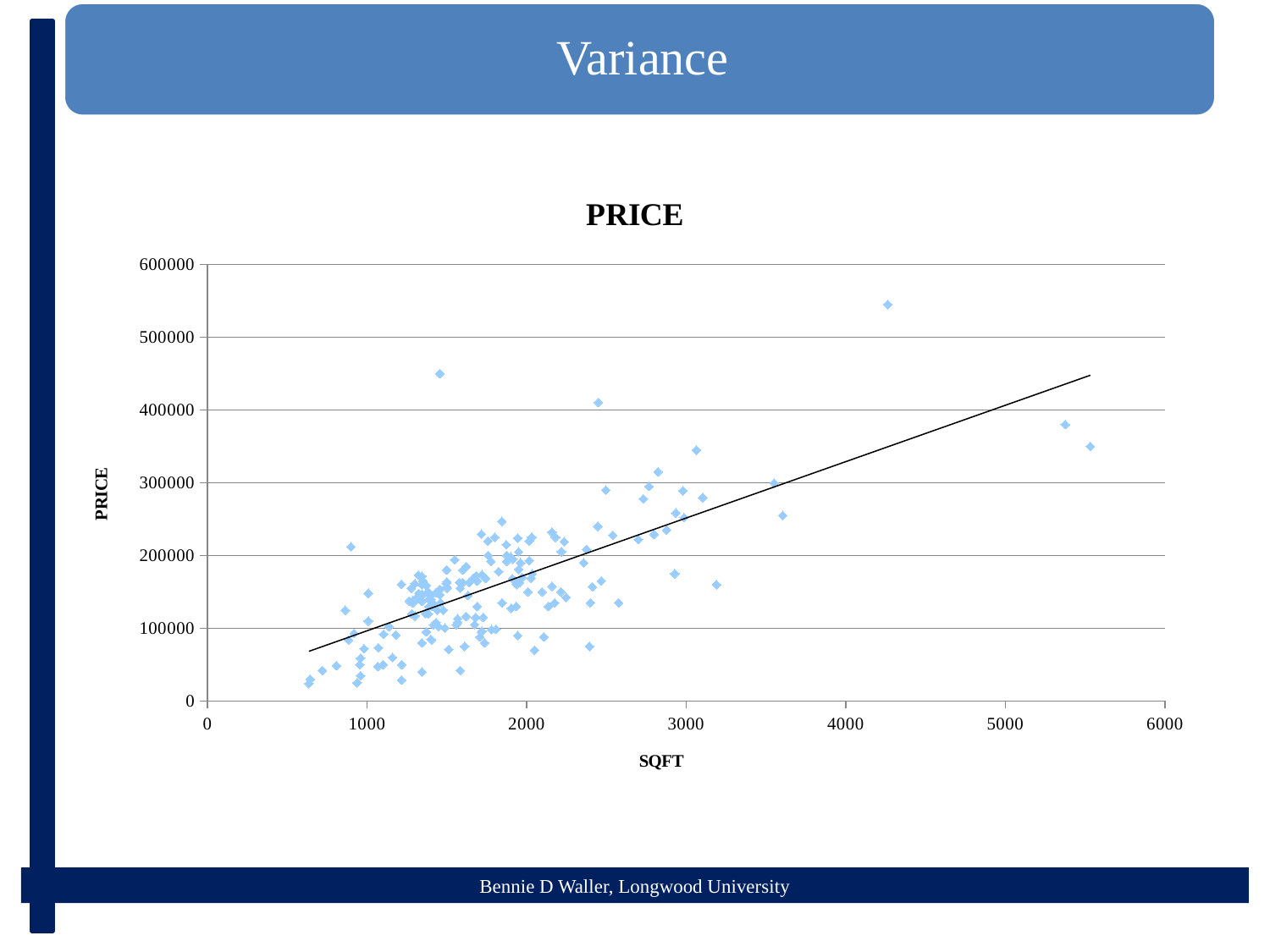
Is the PRICE of the point with the largest SQFT (near 5500) greater or less than 400000? less Is the PRICE of the highest plotted point greater or less than 500000? greater Are any plotted points above 600000 on the PRICE axis? No What is the title of the chart? PRICE As SQFT increases along the x axis, does PRICE generally rise or fall? Rise What is the label on the horizontal axis of the chart? SQFT Does the fitted trend line slope upward or downward from left to right? Upward What kind of chart is shown on the slide? Scatter chart